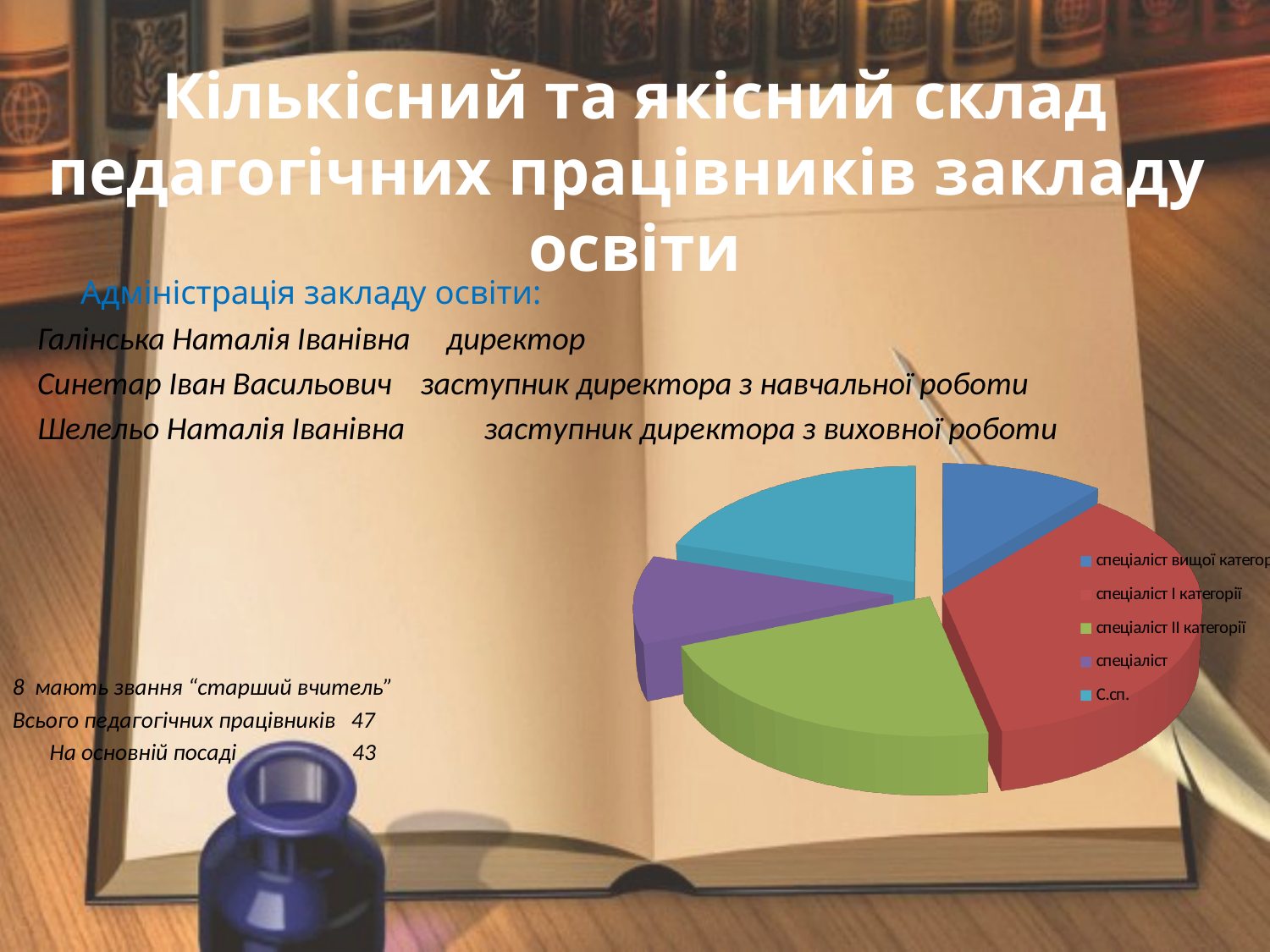
What is the last entry listed in the legend of the pie chart? С.сп. Which slice is larger in the pie chart: спеціаліст І категорії or спеціаліст ІІ категорії? спеціаліст І категорії What colour is the slice for спеціаліст ІІ категорії in the pie chart? green Which category has the largest slice in the pie chart? спеціаліст І категорії What kind of chart is shown on the slide? pie chart How many entries does the legend of the pie chart list? 5 Which slice is larger in the pie chart: С.сп. or спеціаліст вищої категорії? С.сп. How many slices does the pie chart have? 5 Which slice is larger in the pie chart: спеціаліст ІІ категорії or спеціаліст вищої категорії? спеціаліст ІІ категорії